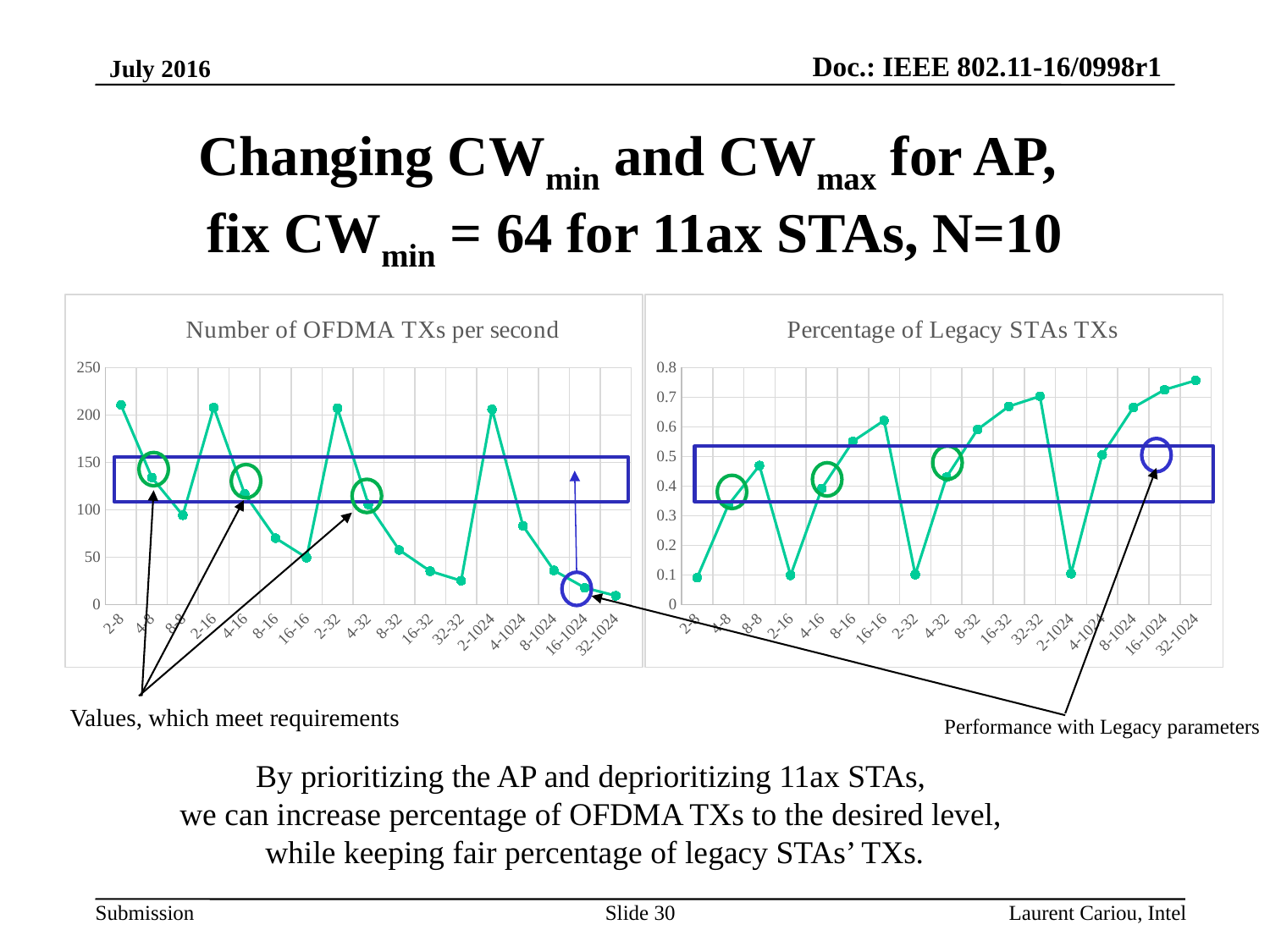
What is the title of the chart on the right side of the slide? Percentage of Legacy STAs TXs In the "Percentage of Legacy STAs TXs" chart, which is larger, the value for 8-8 or the value for 2-16? 8-8 In the "Number of OFDMA TXs per second" chart, which is larger, the value for 4-8 or the value for 8-8? 4-8 In the "Percentage of Legacy STAs TXs" chart, is the value for 16-16 greater or less than 0.6? greater In the "Percentage of Legacy STAs TXs" chart, do the values rise or fall from 2-1024 to 32-1024? rise In the "Number of OFDMA TXs per second" chart, is the value for 2-8 greater or less than 200? greater In the "Percentage of Legacy STAs TXs" chart, is the value for 2-32 greater or less than 0.2? less In the "Number of OFDMA TXs per second" chart, which category has the lowest value? 32-1024 How many categories are plotted on the x axis of the "Percentage of Legacy STAs TXs" chart? 17 In the "Percentage of Legacy STAs TXs" chart, which category has the highest value? 32-1024 What kind of chart is the "Number of OFDMA TXs per second" chart? line chart